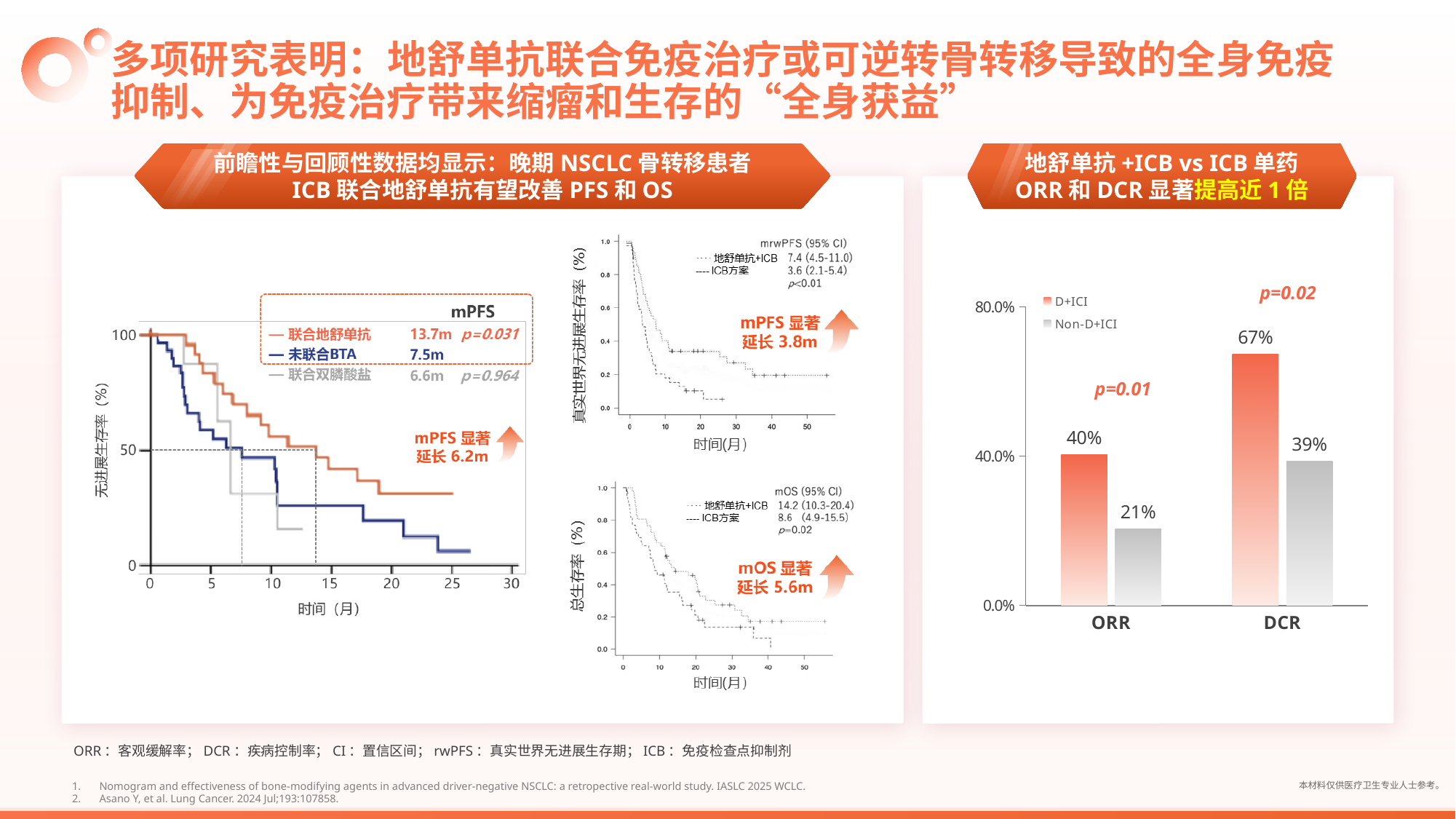
In the bar chart on the right, what is the difference between the DCR values for D+ICI and Non-D+ICI? 28% In the bar chart on the right, what p-value is shown above the ORR bars? p=0.01 In the large survival curve chart on the left, what is the mPFS for 联合双膦酸盐? 6.6m In the top middle survival curve chart, what is the mrwPFS (95% CI) for ICB方案? 3.6 (2.1-5.4) In the bar chart on the right, what is the ORR value for D+ICI? 40% In the bar chart on the right, which bar is the highest? D+ICI DCR (67%) In the bar chart on the right, how many series does the legend list? 2 In the bottom middle survival curve chart, what is the mOS (95% CI) for 地舒单抗+ICB? 14.2 (10.3-20.4) In the bar chart on the right, which bar is the lowest? Non-D+ICI ORR (21%) What kind of chart is shown on the right side of the slide (ORR and DCR)? Bar chart In the bar chart on the right, what is the DCR value for Non-D+ICI? 39% In the large survival curve chart on the left, what is the mPFS for 联合地舒单抗? 13.7m